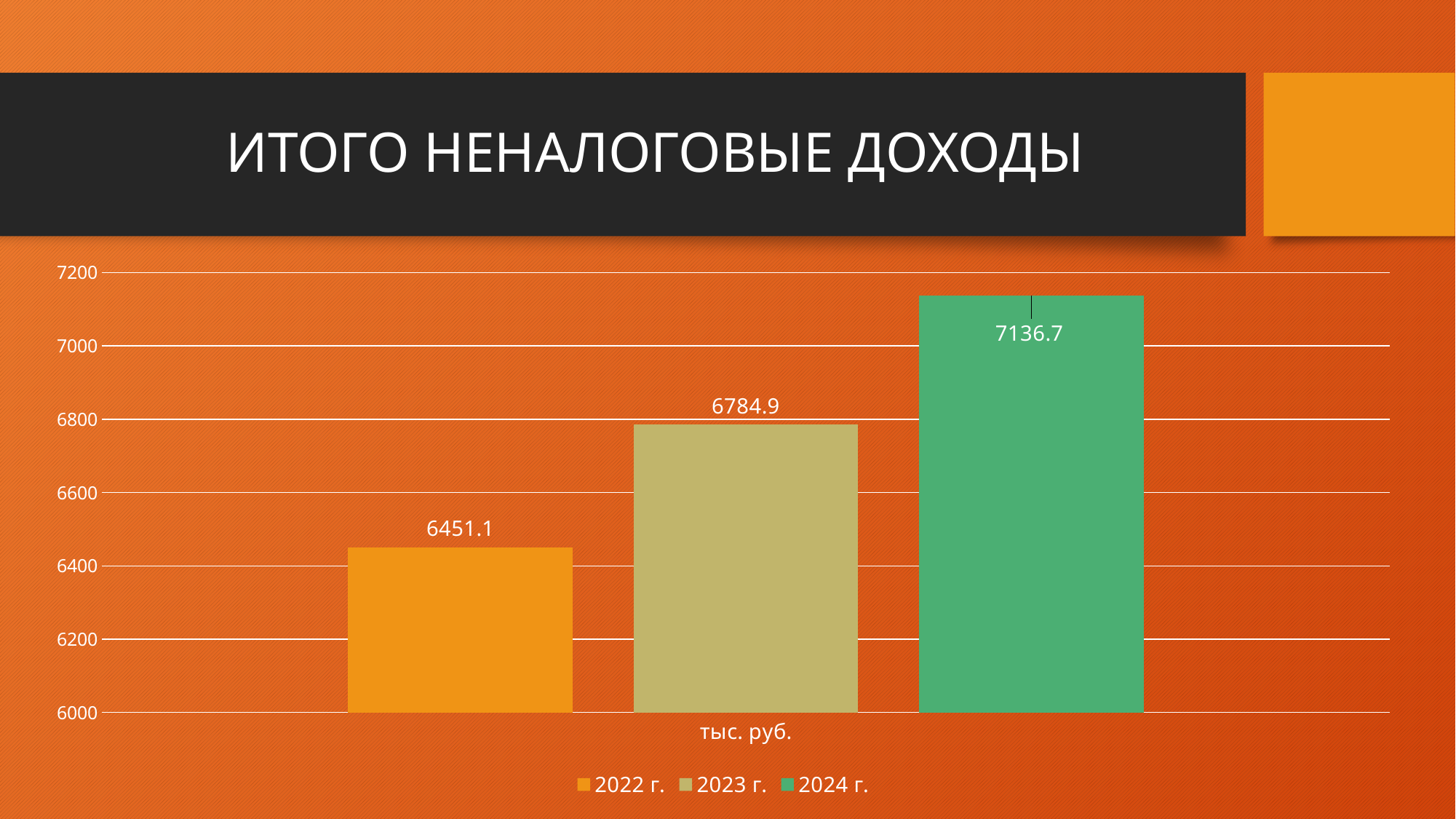
What is the value for 2023 г.? 6784.9 How many series does the legend list? 3 What is the difference between the values for 2024 г. and 2023 г.? 351.8 Which is larger, the value for 2022 г. or the value for 2023 г.? 2023 г. What is the value for 2022 г.? 6451.1 Which year has the lowest value? 2022 г. What is the value for 2024 г.? 7136.7 What kind of chart is shown on the slide? bar chart Do the values rise or fall from 2022 г. to 2024 г.? rise Is the value for 2024 г. greater or less than 7000? greater Which year has the highest value? 2024 г. What is the difference between the values for 2023 г. and 2022 г.? 333.8